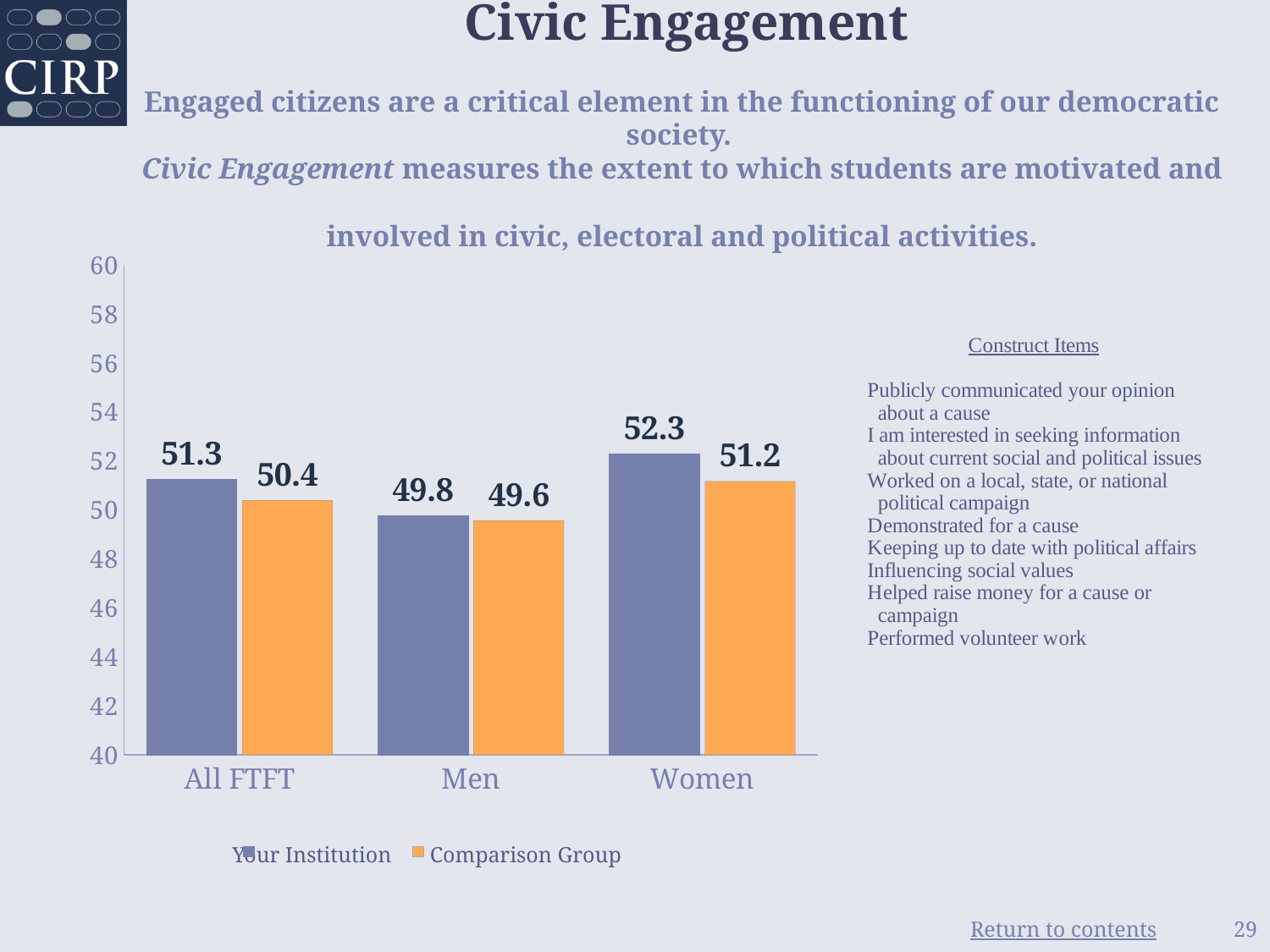
What is the Your Institution value for Women? 52.3 What is the difference between the Your Institution and Comparison Group values for Women? 1.1 Which series is shown in orange? Comparison Group How many series does the legend list? 2 What is the Comparison Group value for Men? 49.6 What kind of chart is shown on the slide? Bar chart What is the Your Institution value for All FTFT? 51.3 Which category has the highest Your Institution value? Women How many categories are shown on the x axis? 3 What is the difference between the Your Institution values for Women and Men? 2.5 Which category has the lowest Comparison Group value? Men Which is larger for All FTFT: Your Institution or Comparison Group? Your Institution